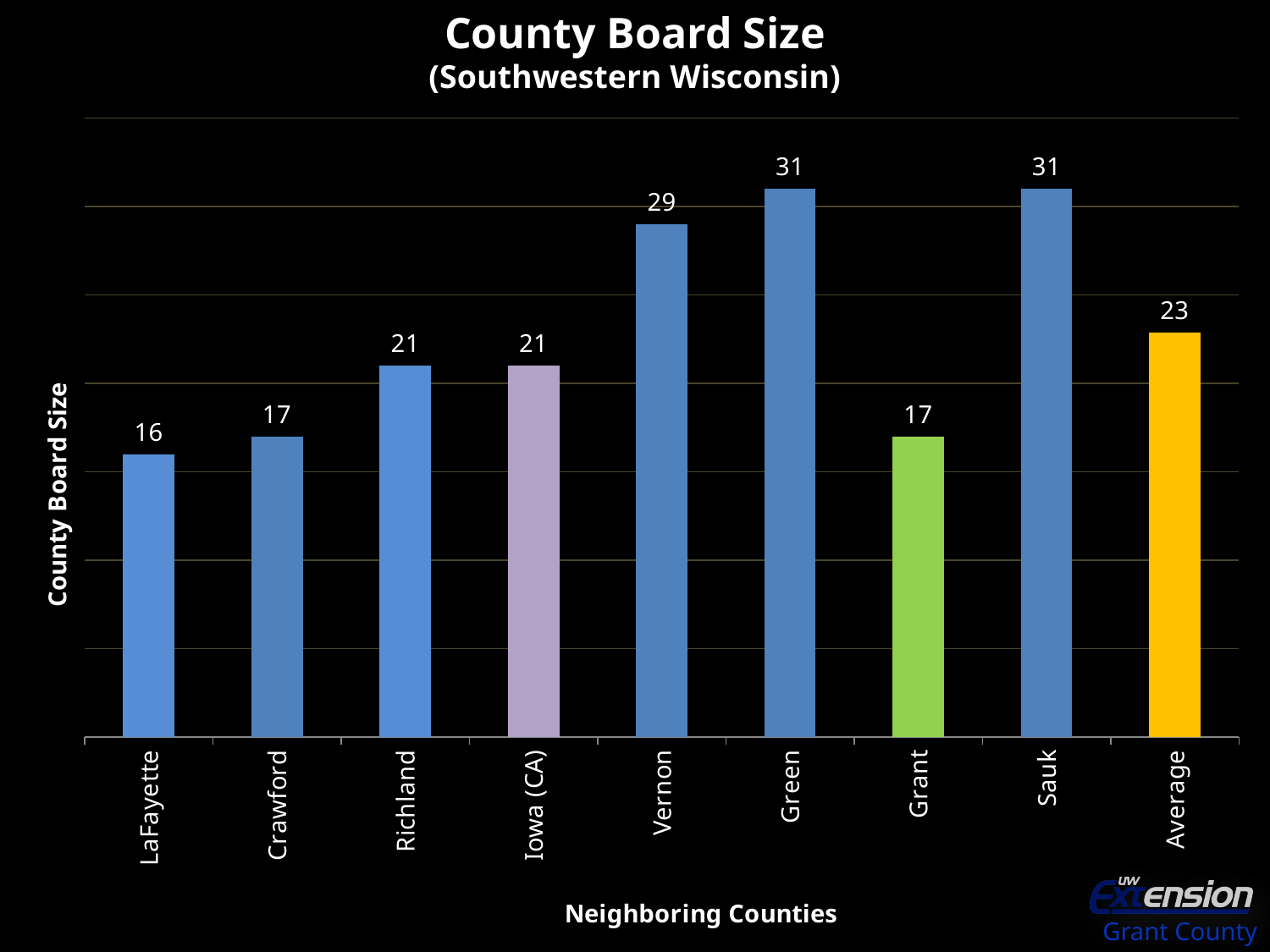
What type of chart is shown on the slide? Bar chart What is the county board size for Grant? 17 What is the label of the x axis? Neighboring Counties How many bars are shown on the chart? 9 What is the title of the chart? County Board Size (Southwestern Wisconsin) Which has a larger county board size, Richland or Crawford? Richland Which has a larger county board size, Vernon or Sauk? Sauk Which county has the smallest county board size? LaFayette What is the difference in county board size between Green and LaFayette? 15 What is the county board size for Vernon? 29 What is the value shown for the Average bar? 23 What is the difference between the Average value and Grant's county board size? 6